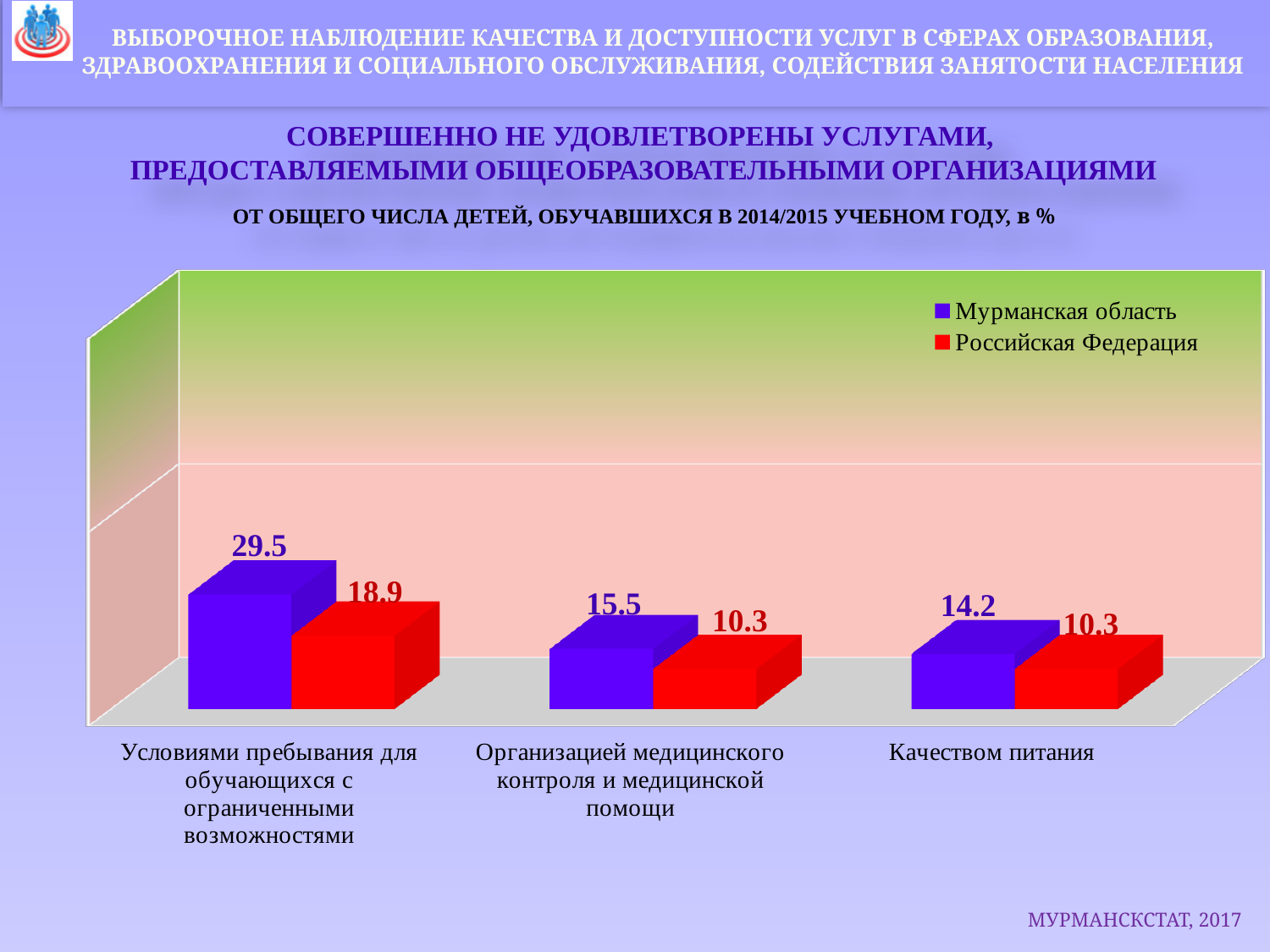
What is the difference between the Мурманская область and Российская Федерация values in the category 'Условиями пребывания для обучающихся с ограниченными возможностями'? 10.6 Which category has the lowest value for Мурманская область? Качеством питания How many series does the legend list? 2 Which is larger in the category 'Организацией медицинского контроля и медицинской помощи': Мурманская область or Российская Федерация? Мурманская область How many categories are shown on the x axis? 3 Which category has the highest value for Мурманская область? Условиями пребывания для обучающихся с ограниченными возможностями What is the difference between the Мурманская область and Российская Федерация values in the category 'Качеством питания'? 3.9 What is the value for Российская Федерация in the category 'Качеством питания'? 10.3 What is the value for Мурманская область in the category 'Условиями пребывания для обучающихся с ограниченными возможностями'? 29.5 Which colour represents Российская Федерация in the chart? Red What kind of chart is shown on the slide? Bar chart What is the value for Мурманская область in the category 'Организацией медицинского контроля и медицинской помощи'? 15.5